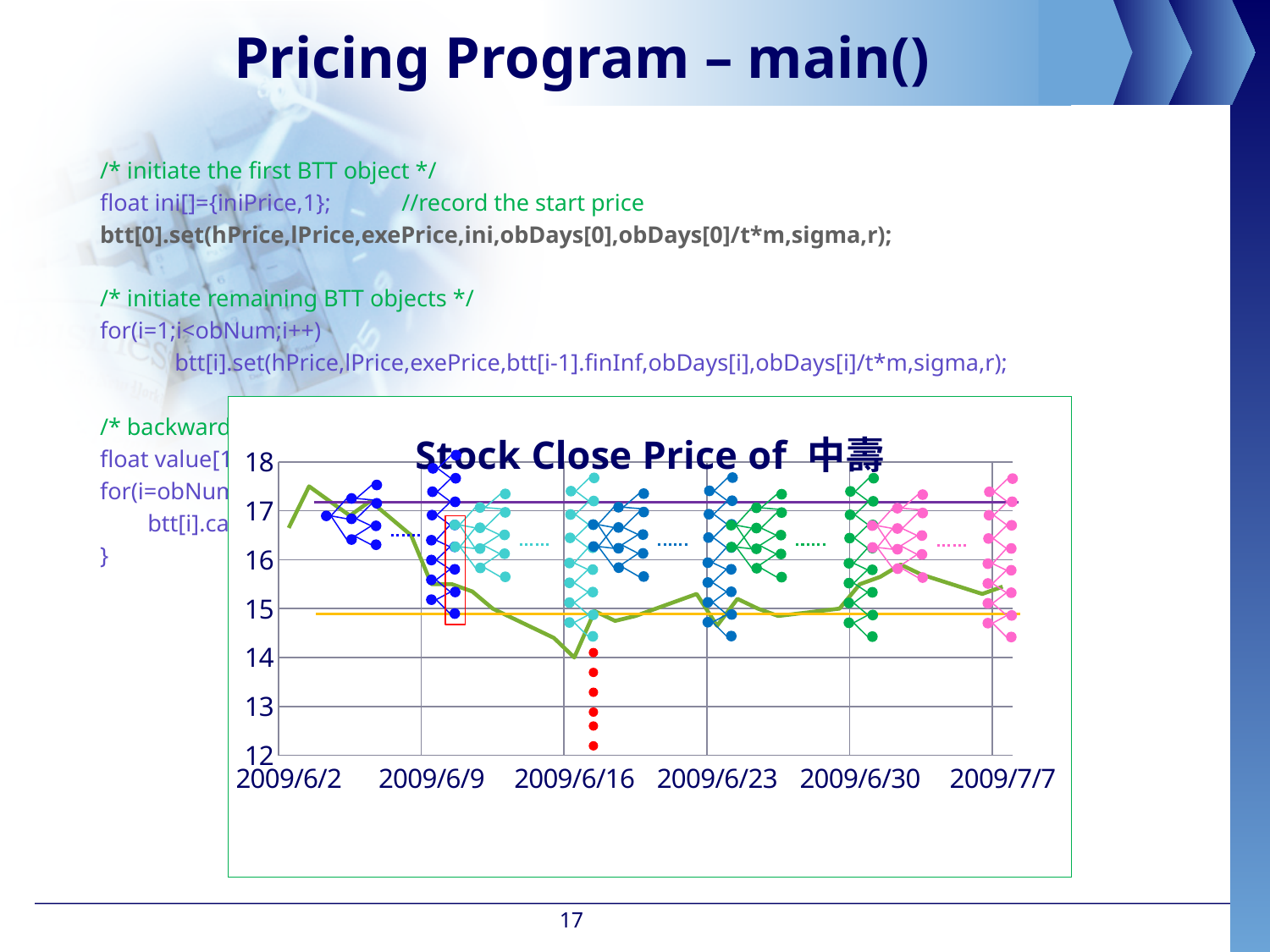
What is the first date label shown on the x axis of the chart? 2009/6/2 Does the green close-price line generally rise or fall between 2009/6/2 and 2009/6/16? fall What is the title of the chart on the slide? Stock Close Price of 中壽 How many date labels are shown on the x axis of the chart? 6 Is the green close-price line at 2009/6/2 greater or less than 16? greater Is the green close-price line at 2009/6/16 greater or less than 15? less What kind of chart is shown on the slide? line chart Is the purple horizontal line on the chart greater or less than 17? greater What is the last date label shown on the x axis of the chart? 2009/7/7 What is the highest value shown on the y axis of the chart? 18 What is the lowest value shown on the y axis of the chart? 12